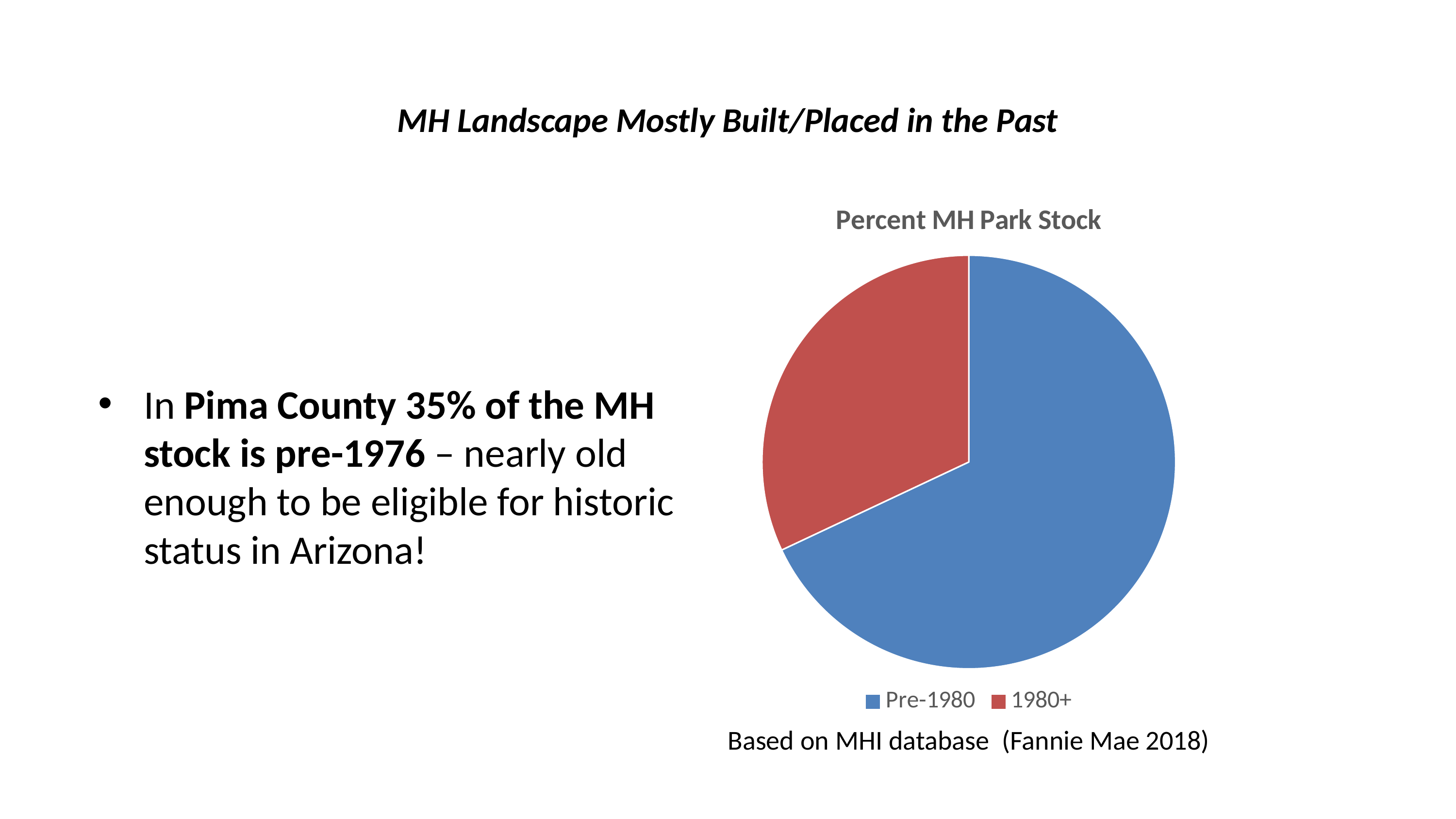
Which category has the largest slice in the pie chart? Pre-1980 What kind of chart is shown on the slide? Pie chart What is the title of the pie chart? Percent MH Park Stock How many slices does the pie chart have? 2 Which slice is larger in the pie chart, Pre-1980 or 1980+? Pre-1980 Which category has the smallest slice in the pie chart? 1980+ How many entries does the legend of the pie chart list? 2 Which category is shown in red in the pie chart? 1980+ What colour is the Pre-1980 slice in the pie chart? Blue